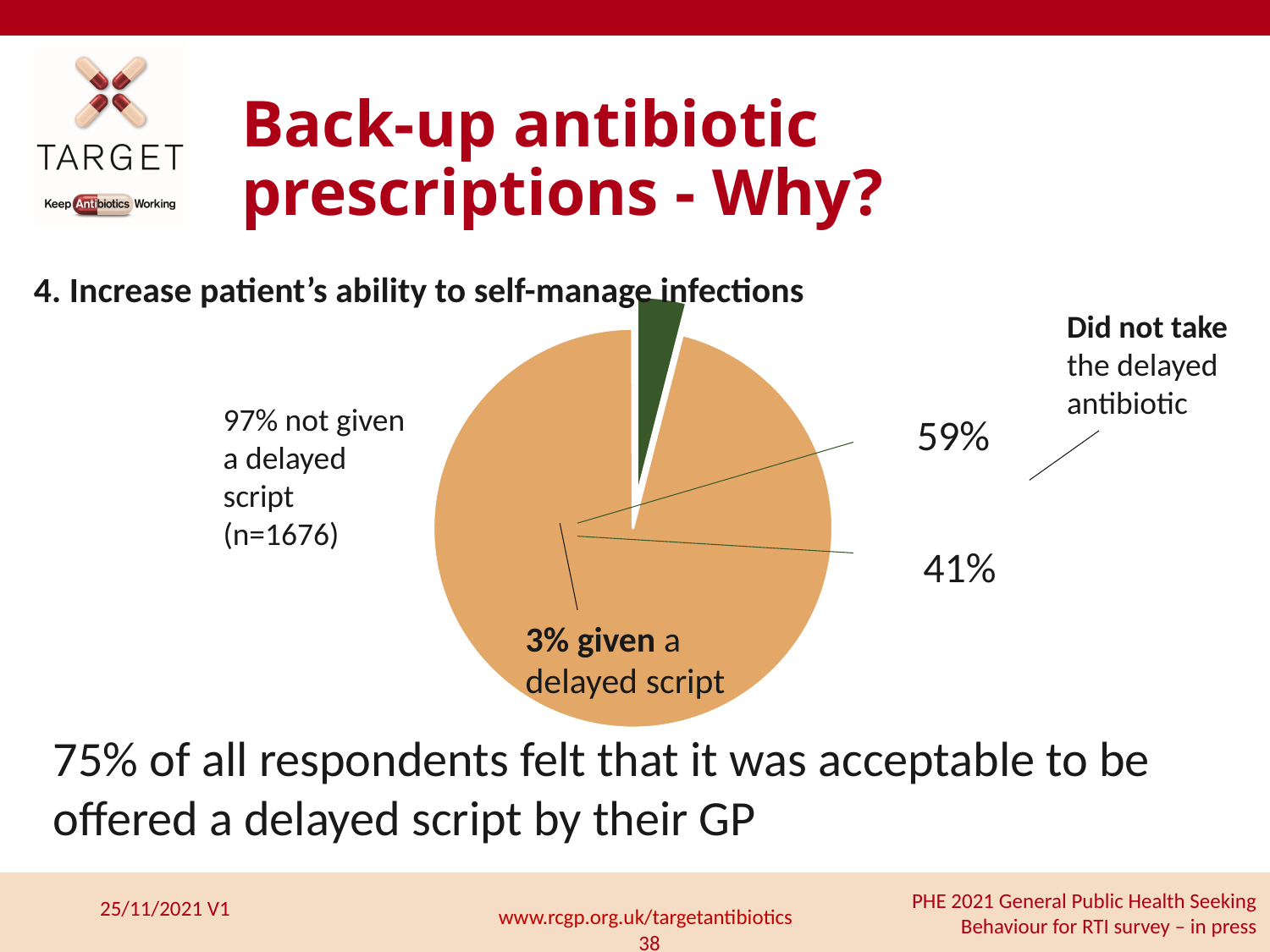
Which slice of the pie chart is the smallest? 3% given a delayed script How many slices does the pie chart have? 2 Of those given a delayed script, what percentage did not take the delayed antibiotic? 59% What is the sample size (n) shown for respondents not given a delayed script? n=1676 What colour is the slice representing the 3% given a delayed script? Dark green What is the other percentage shown for the 'given a delayed script' group, besides 59%? 41% What is the difference in percentage points between the 'not given a delayed script' slice and the 'given a delayed script' slice? 94 percentage points What percentage of respondents were not given a delayed script? 97% What percentage of respondents were given a delayed script? 3% Which slice of the pie chart is the largest? 97% not given a delayed script What kind of chart is shown on the slide? Pie chart Among those given a delayed script, which is larger: the share that did not take the delayed antibiotic (59%) or the remaining share (41%)? Did not take the delayed antibiotic (59%)